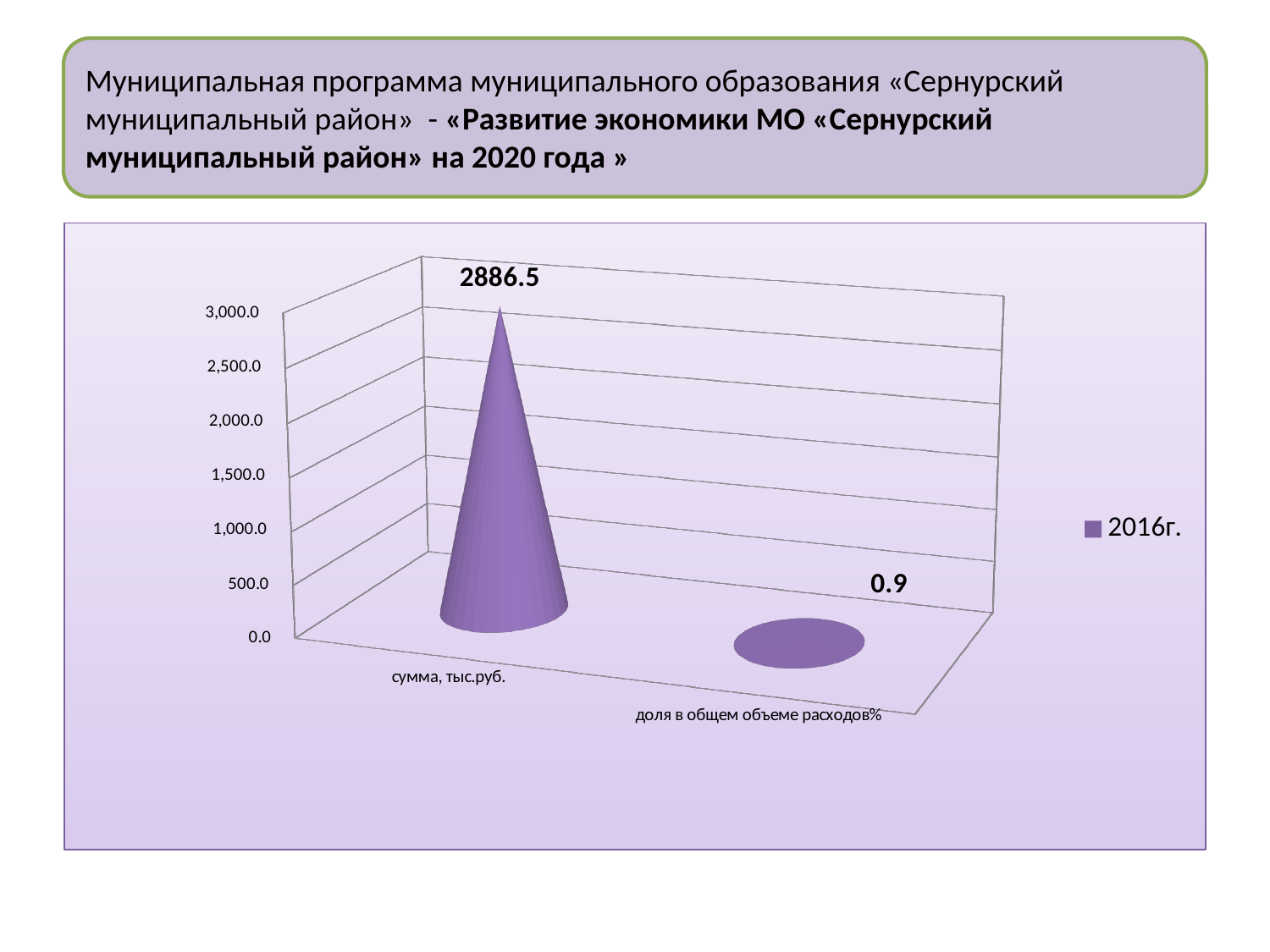
What is the value for "сумма, тыс.руб."? 2886.5 What kind of chart is shown on the slide? bar chart How many categories are shown on the chart? 2 What is the value for "доля в общем объеме расходов%"? 0.9 Is the value for "доля в общем объеме расходов%" greater or less than 500.0? less What is the difference between the values for "сумма, тыс.руб." and "доля в общем объеме расходов%"? 2885.6 Which category has the highest value? сумма, тыс.руб. Is the value for "сумма, тыс.руб." greater or less than 2,500.0? greater What series name is shown in the chart legend? 2016г. Which is larger: the value for "сумма, тыс.руб." or the value for "доля в общем объеме расходов%"? сумма, тыс.руб. How many series does the legend list? 1 Which category has the lowest value? доля в общем объеме расходов%